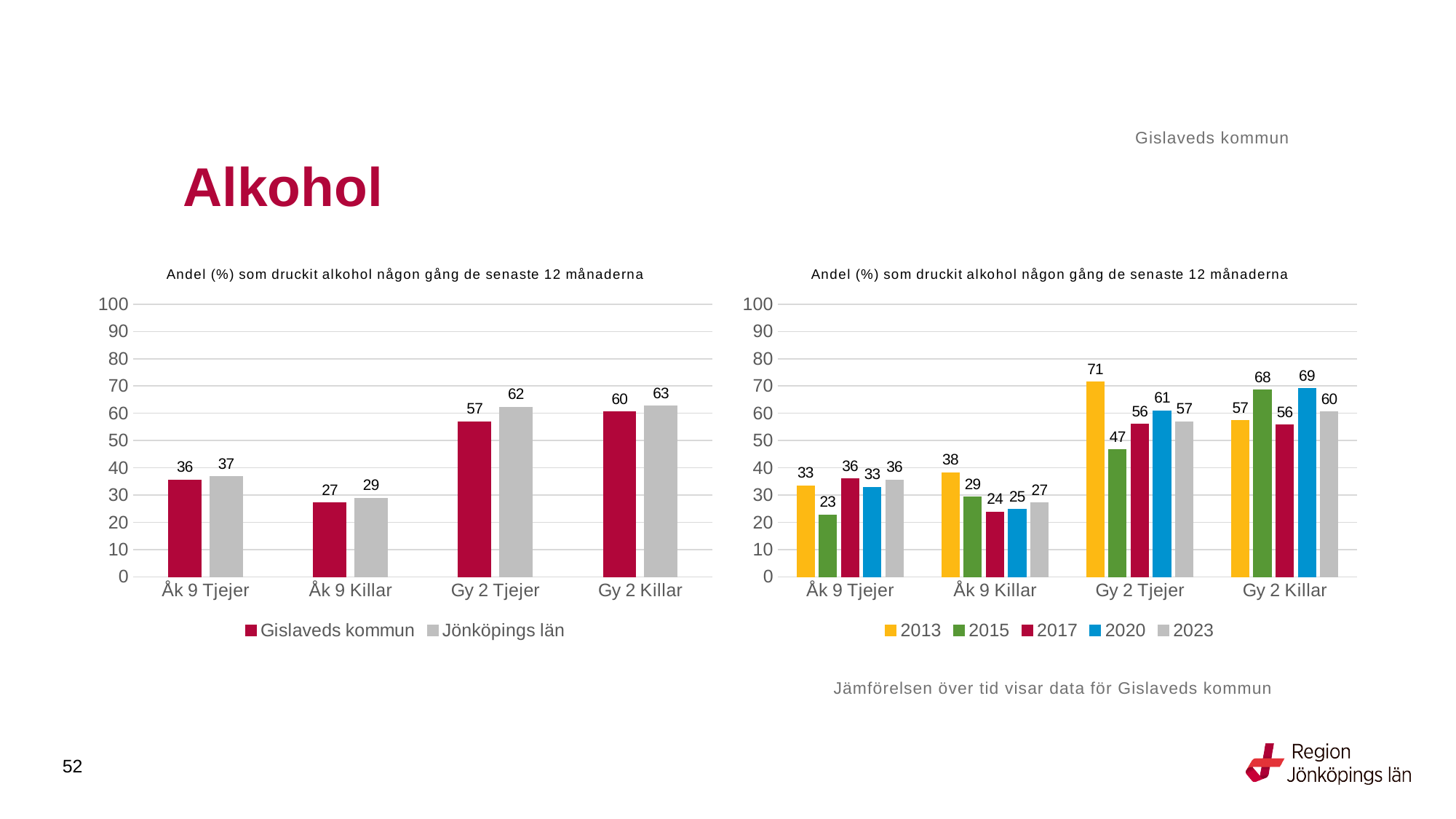
In the left chart, how many series does the legend list? 2 In the right chart, is the value for 2013 for Åk 9 Killar larger or smaller than the value for 2023 for Åk 9 Killar? larger In the right chart, what is the value for 2015 for Åk 9 Tjejer? 23 In the right chart, what is the difference between the 2013 and 2015 values for Gy 2 Tjejer? 24 In the left chart, which category has the lowest value for Gislaveds kommun? Åk 9 Killar In the left chart, what is the value for Gislaveds kommun for Gy 2 Tjejer? 57 In the left chart, what is the value for Jönköpings län for Åk 9 Killar? 29 In the right chart, which year has the highest value for Gy 2 Killar? 2020 In the left chart, what is the difference between Jönköpings län and Gislaveds kommun for Gy 2 Tjejer? 5 In the right chart, how many series does the legend list? 5 What kind of chart is the left chart? Bar chart In the right chart, what is the value for 2013 for Gy 2 Tjejer? 71